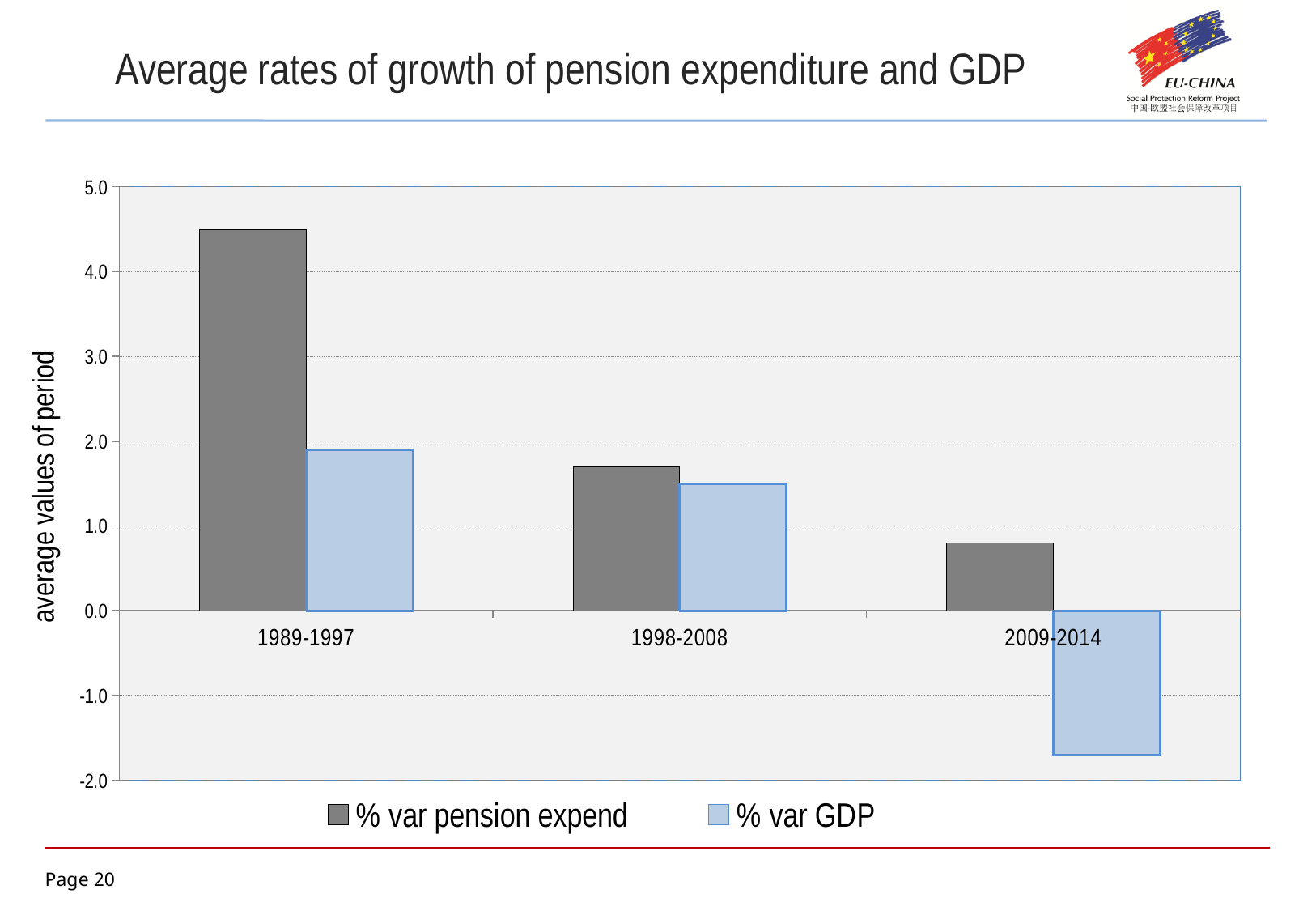
Is the value for % var pension expend in 1989-1997 greater or less than 4.0? greater What kind of chart is shown on the slide? bar chart Which period has the highest value for % var pension expend? 1989-1997 Is the value for % var GDP in 1989-1997 greater or less than 2.0? less Is the value for % var GDP in 2009-2014 greater or less than -1.0? less Which period has the lowest value for % var GDP? 2009-2014 How many periods are shown on the x axis? 3 How many series does the legend list? 2 What is the label of the y axis? average values of period In 1989-1997, which is larger: % var pension expend or % var GDP? % var pension expend Do the values for % var pension expend rise or fall across the periods from 1989-1997 to 2009-2014? fall